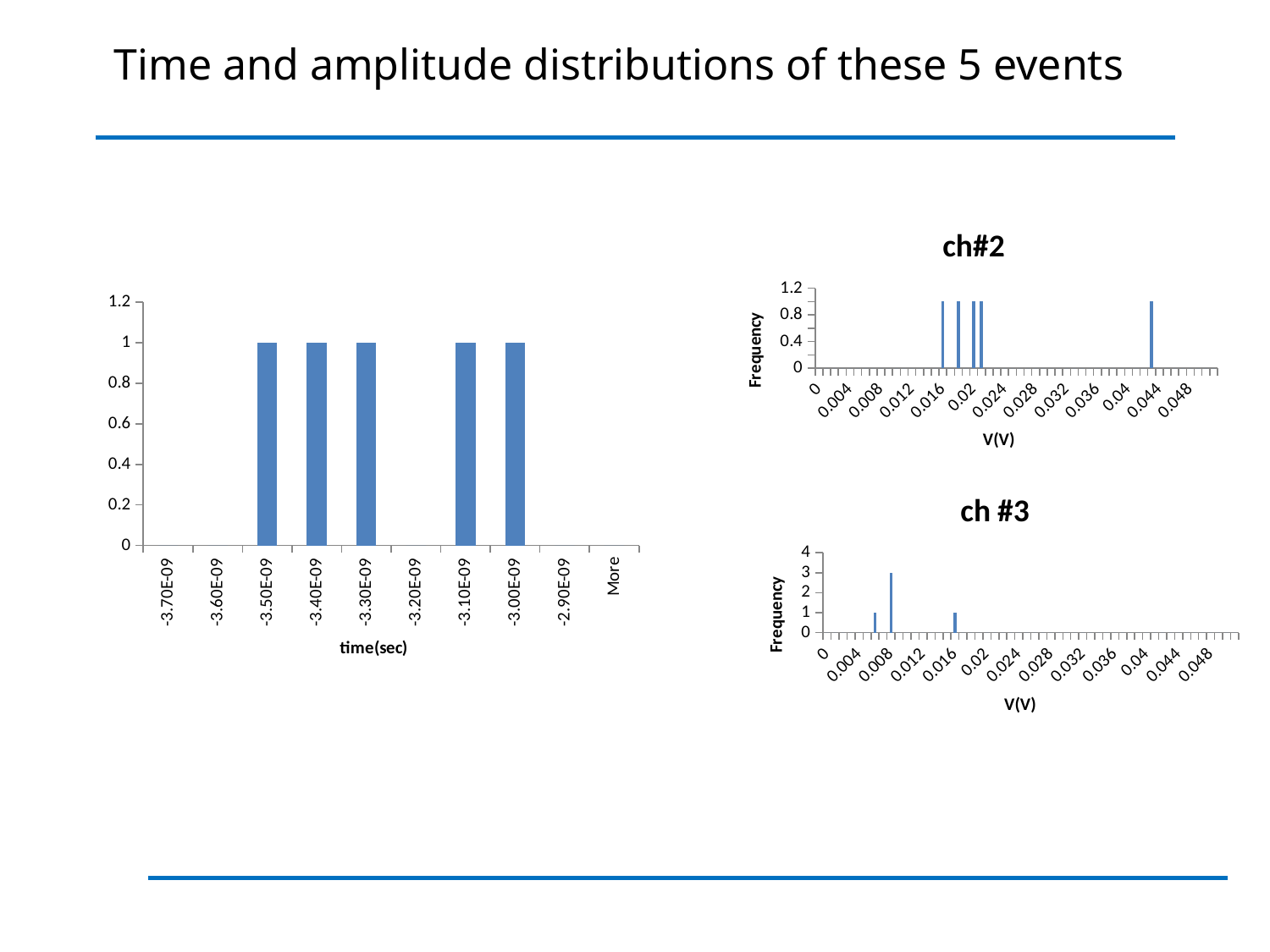
In the left chart (time(sec)), how many categories are labelled on the x axis? 10 In the ch#2 chart, is the value of the bar near 0.043 greater or less than 0.8? greater In the left chart (time(sec)), what is the value of the bar at -3.50E-09? 1 In the left chart (time(sec)), how many bars have a non-zero value? 5 In the left chart (time(sec)), is the value for -3.20E-09 greater or less than 0.2? less In the ch #3 chart, what is the highest frequency value reached by any bar? 3 In the ch#2 chart, how many non-zero bars are plotted? 5 What is the y-axis label of the ch#2 chart? Frequency What is the x-axis label of the left chart? time(sec) In the left chart (time(sec)), what is the value of the bar at -3.00E-09? 1 What kind of chart is the left chart with the time(sec) axis? bar chart